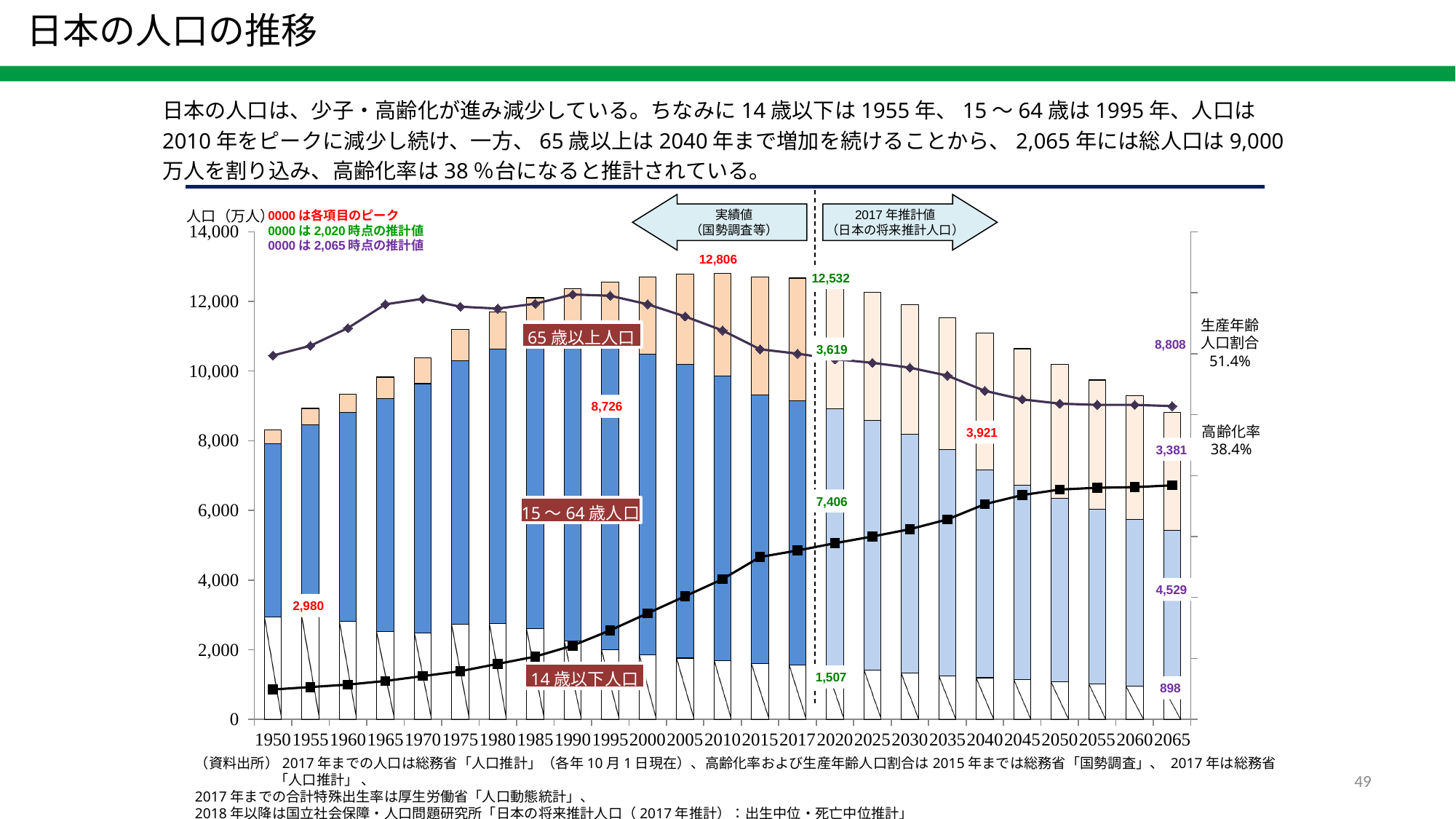
What is the 高齢化率 (ageing rate) shown for 2065? 38.4% What is the 15～64歳人口 value labelled for 2020? 7,406 What is the peak value of the 14歳以下人口 (population aged 14 and under) shown on the chart? 2,980 What kind of chart is used to show the population by age group? stacked bar chart What is the total population value labelled for 2020? 12,532 Which year has the highest total population on the chart? 2010 What is the 65歳以上人口 (population aged 65 and over) value labelled for 2065? 3,381 Is the total population bar for 1950 greater or less than 8,000? greater How many years are shown on the x axis of the chart? 25 What is the difference between the labelled total population for 2020 and for 2065? 3,724 What is the total population value labelled for 2065? 8,808 Which is larger, the 65歳以上人口 value for 2020 or for 2065? 2020